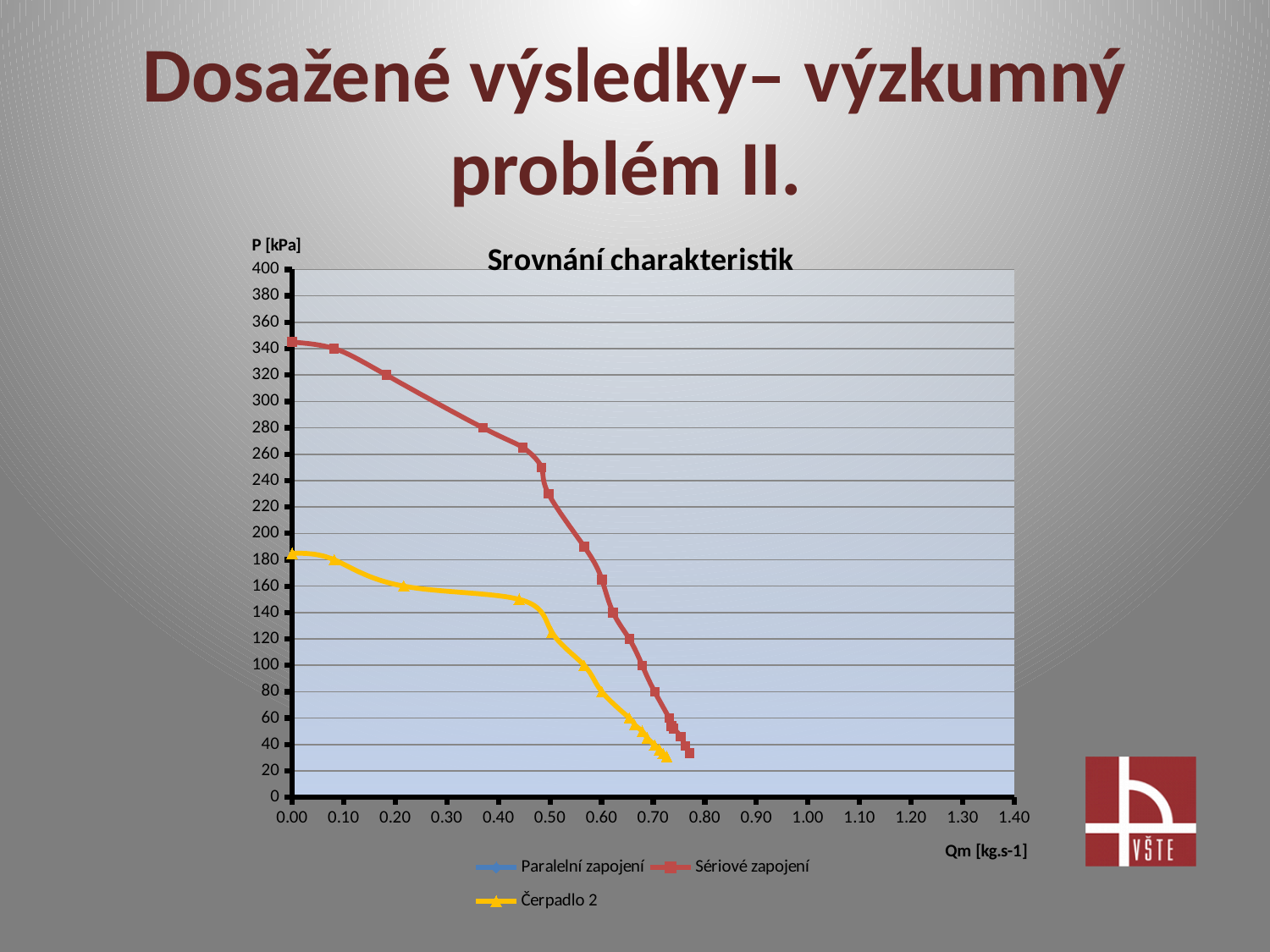
What is the title of the chart? Srovnání charakteristik Do the values of the Čerpadlo 2 series rise or fall as Qm increases? fall Is the value for Čerpadlo 2 at Qm = 0.30 greater or less than 140? greater How many series does the chart legend list? 3 Is the value for Sériové zapojení at Qm = 0.40 greater or less than 240? greater Is the value for Sériové zapojení at Qm = 0.00 greater or less than 300? greater What is the label of the vertical axis? P [kPa] At Qm = 0.20, which series has the higher value, Sériové zapojení or Čerpadlo 2? Sériové zapojení Do the values of the Sériové zapojení series rise or fall as Qm increases? fall What kind of chart is shown on the slide? line chart Which series reaches the highest pressure value on the chart? Sériové zapojení